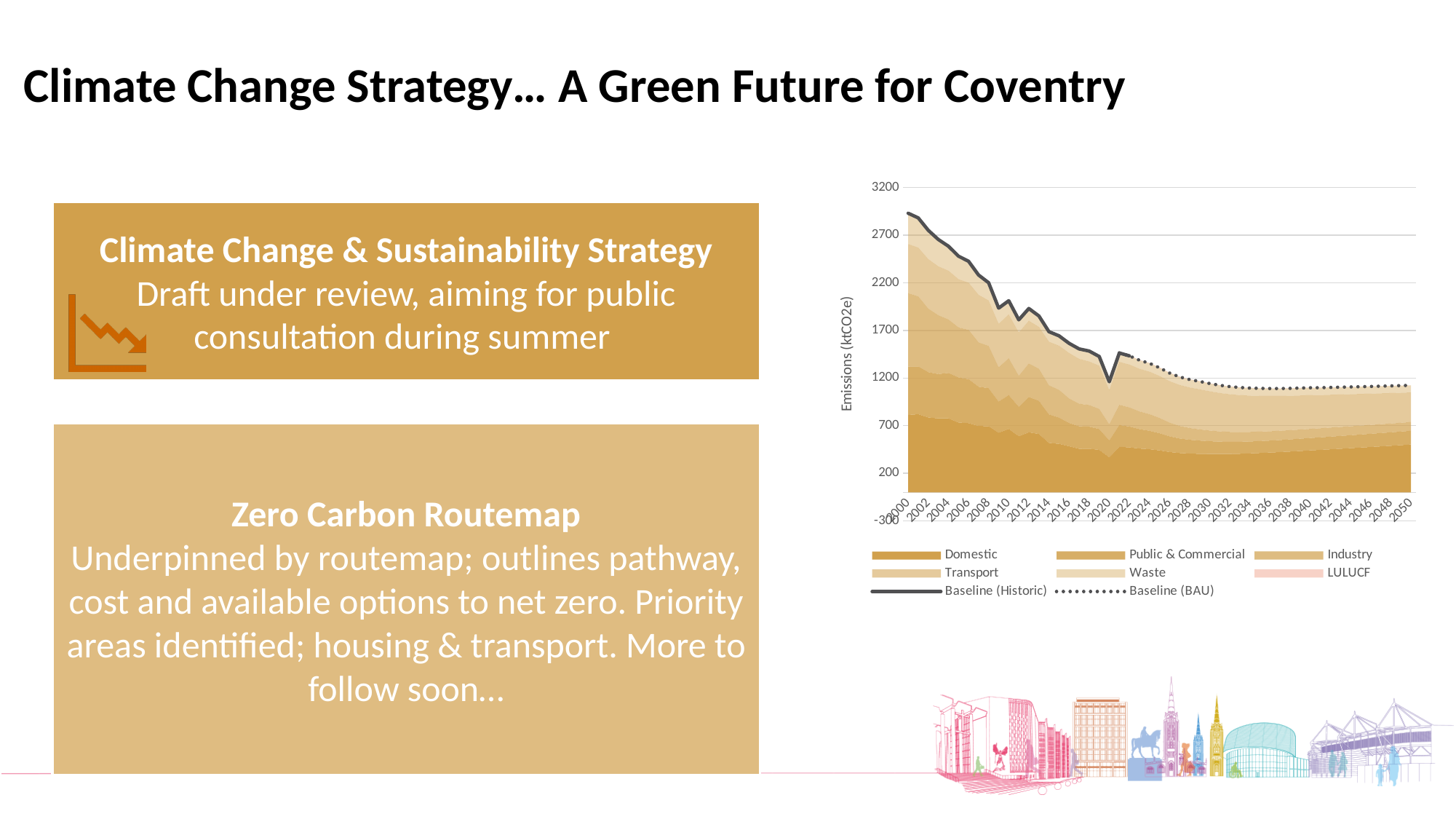
Is the Baseline (Historic) value in 2000 larger or smaller than its value in 2020? Larger What is the first year shown on the x axis of the chart? 2000 Is the Baseline (BAU) value in 2050 greater or less than 1200? less What kind of chart is shown on the slide? Stacked area chart with line series Is the Baseline (Historic) value in 2000 greater or less than 2700? greater Which legend entry is drawn as a dotted line? Baseline (BAU) In which year does the Baseline (Historic) line reach its highest value? 2000 How many series does the chart legend list? 8 What is the label on the vertical axis of the chart? Emissions (ktCO2e) Does the Baseline (Historic) line rise or fall between 2000 and 2020? Fall What is the last year shown on the x axis of the chart? 2050 Is the Baseline (Historic) value in 2010 greater or less than 1700? greater